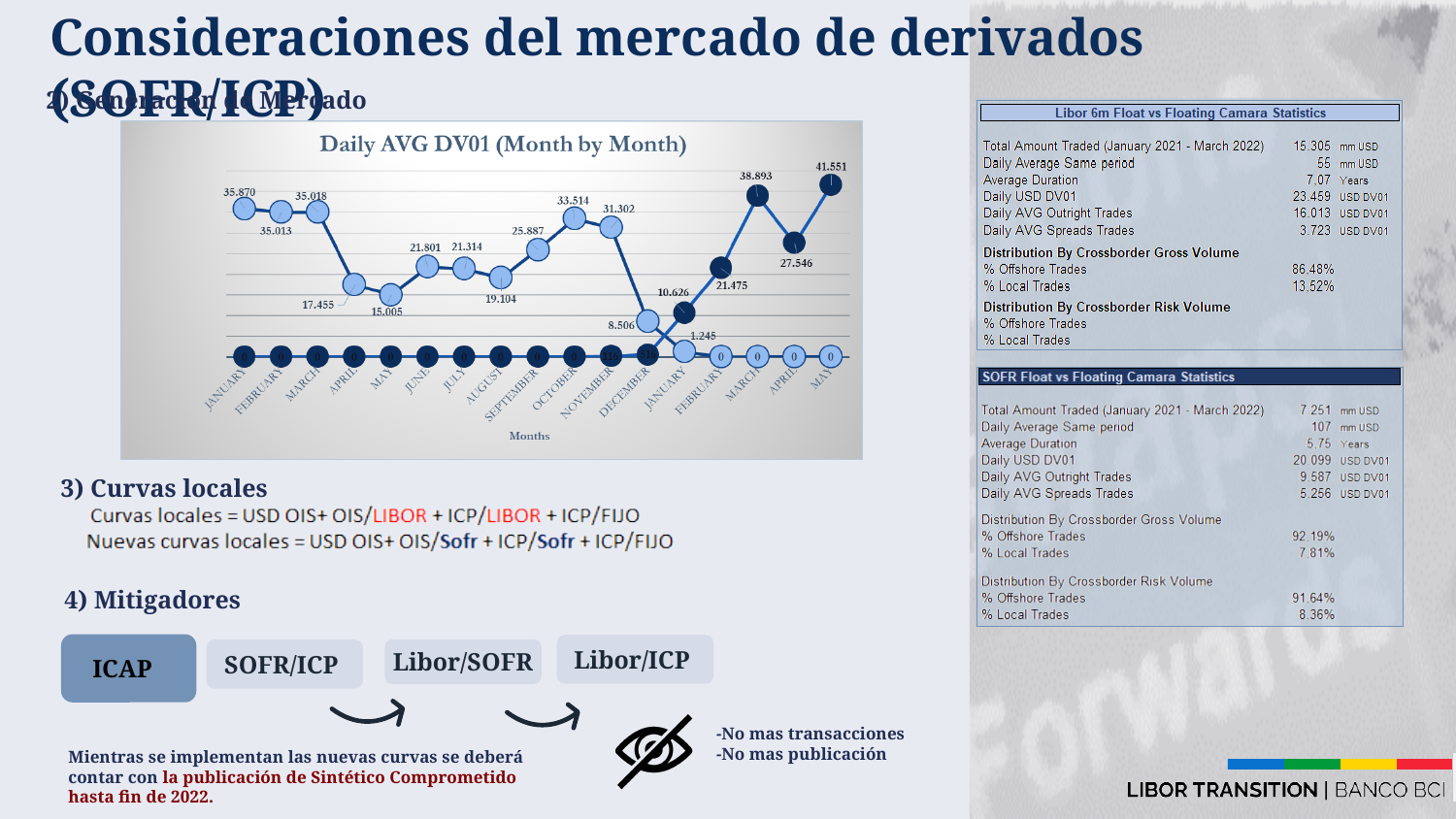
In the 'Daily AVG DV01 (Month by Month)' chart, what value is labeled for September? 25.887 In the 'Daily AVG DV01 (Month by Month)' chart, do the dark blue series values rise or fall from the second February (21.475) to the second May (41.551)? rise In the 'Daily AVG DV01 (Month by Month)' chart, which is larger, the October value or the November value? October How many months are shown on the x axis of the 'Daily AVG DV01 (Month by Month)' chart? 17 In the 'Daily AVG DV01 (Month by Month)' chart, what value is labeled for the first January? 35.870 What is the x-axis title of the 'Daily AVG DV01 (Month by Month)' chart? Months In the 'Daily AVG DV01 (Month by Month)' chart, what is the highest labeled value? 41.551 What kind of chart is 'Daily AVG DV01 (Month by Month)'? line chart In the 'Daily AVG DV01 (Month by Month)' chart, what value is labeled for the first April? 17.455 What is the title of the chart on the left of the slide? Daily AVG DV01 (Month by Month)